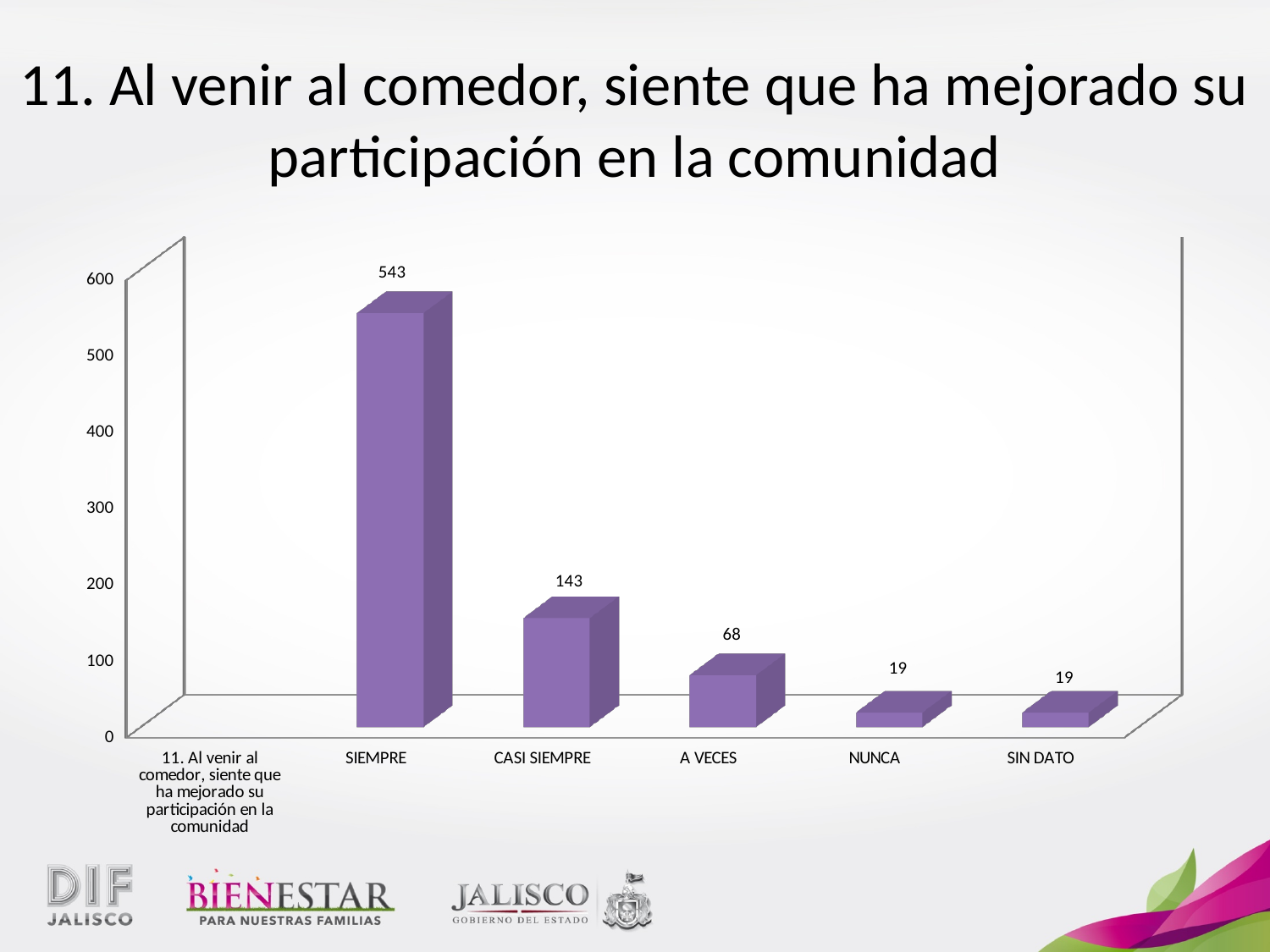
Is the value for SIEMPRE greater or less than 500? greater What is the difference between the values for SIEMPRE and CASI SIEMPRE? 400 What is the value for NUNCA? 19 What is the value for SIEMPRE? 543 How many bars with a plotted value does the chart show? 5 What is the value for CASI SIEMPRE? 143 Which category has the highest value? SIEMPRE Do the values rise or fall from SIEMPRE to NUNCA along the x axis? fall What kind of chart is shown on the slide? bar chart What is the value for A VECES? 68 What is the difference between the values for CASI SIEMPRE and A VECES? 75 Which is larger, the value for A VECES or the value for SIN DATO? A VECES